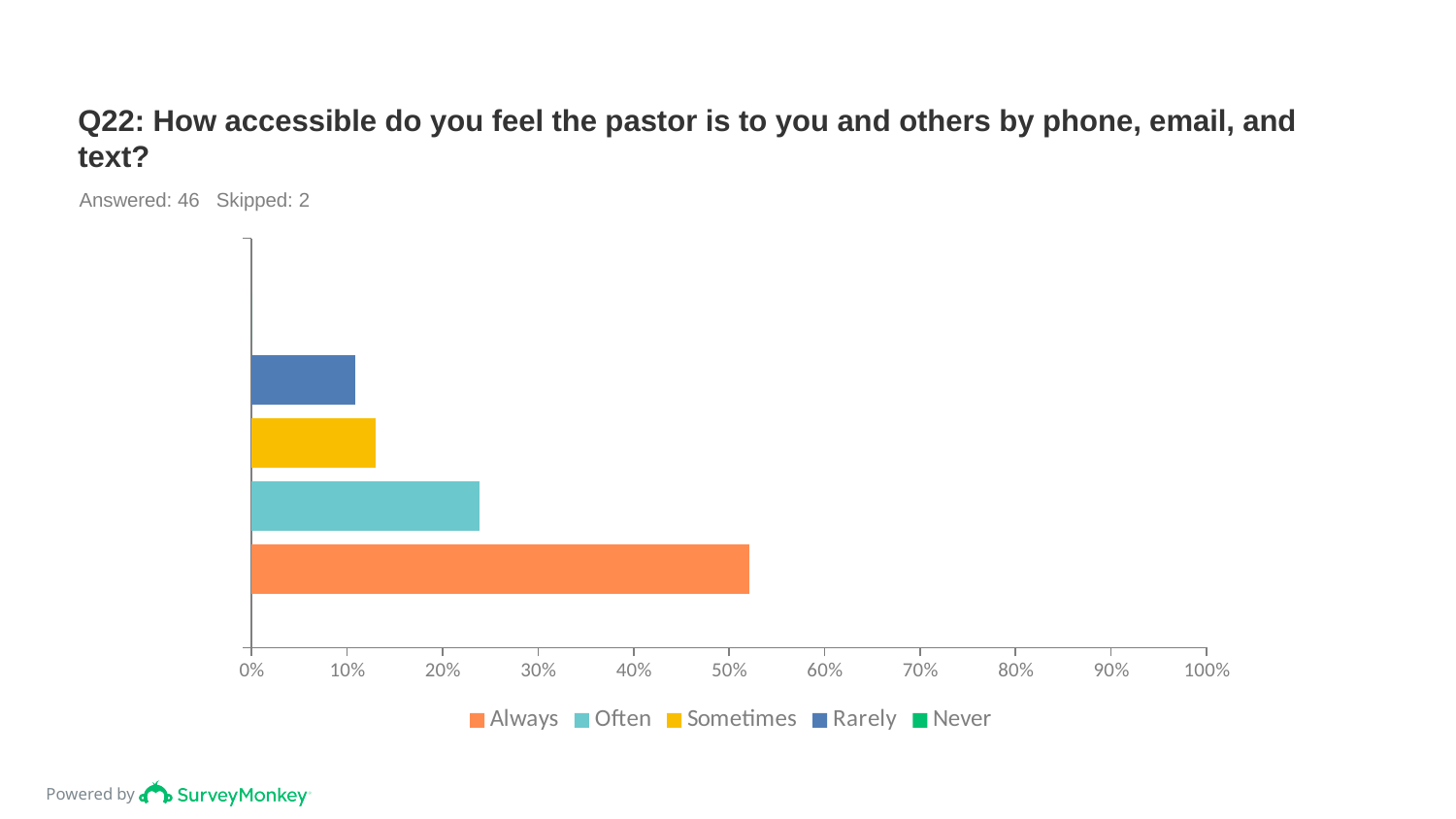
How many series does the legend list? 5 Which response option has the highest value? Always How many respondents answered this question according to the slide? 46 Is the value for Sometimes greater or less than 20%? less What kind of chart is shown on the slide? bar chart What colour is the bar for Always in the legend? orange Is the value for Often greater or less than 30%? less Which is larger, the value for Often or the value for Sometimes? Often Which is larger, the value for Always or the value for Often? Always Is the value for Often greater or less than 20%? greater